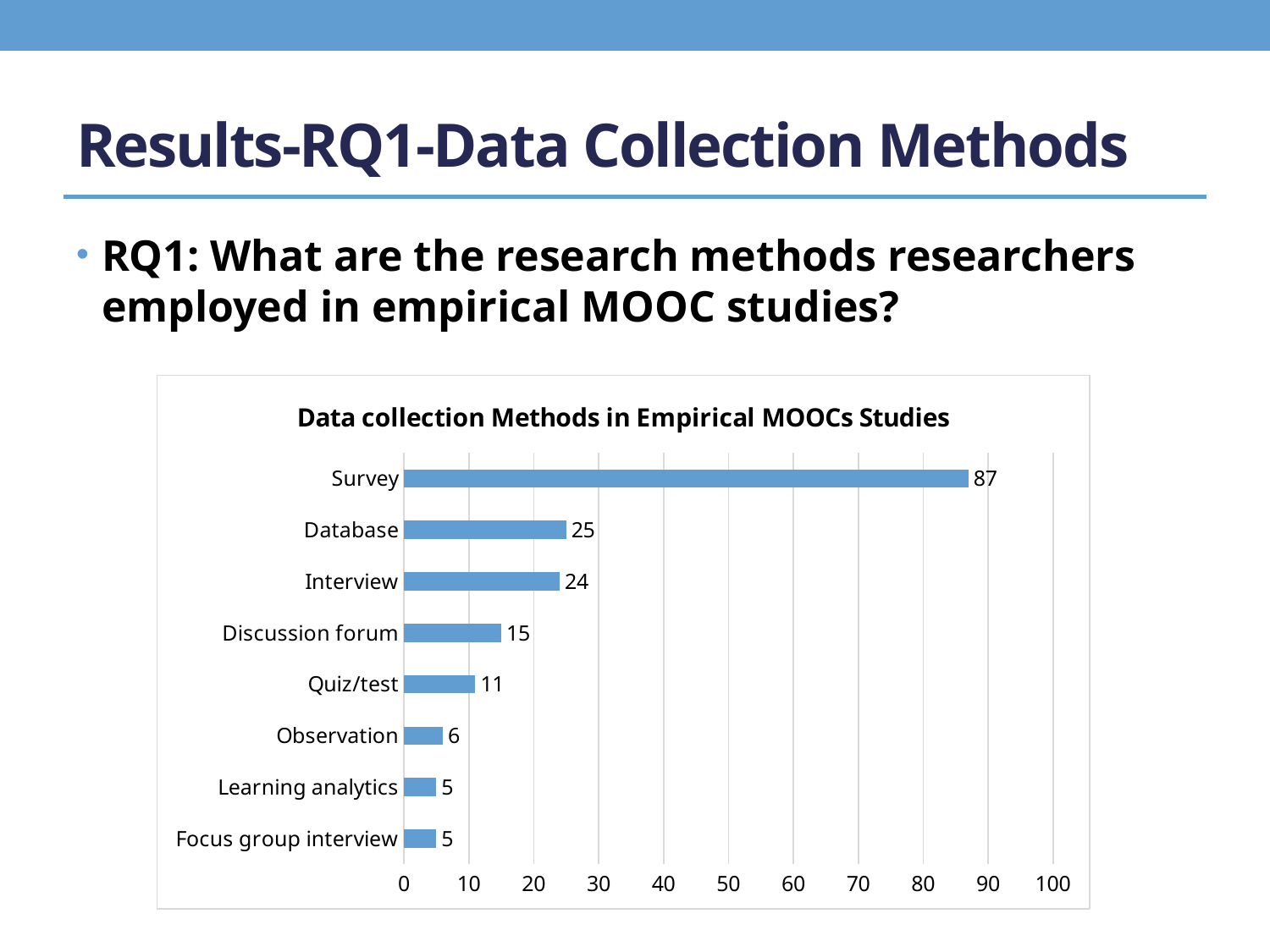
Which is larger, the value for Observation or the value for Discussion forum? Discussion forum Which is larger, the value for Database or the value for Quiz/test? Database How many data collection methods are shown in the chart? 8 What is the value for Discussion forum? 15 What is the value for Survey? 87 What is the title of the chart? Data collection Methods in Empirical MOOCs Studies What is the value for Quiz/test? 11 What kind of chart is shown on the slide? Bar chart Is the value for Survey greater or less than 80? greater What is the difference between the values for Interview and Discussion forum? 9 Which data collection method has the highest value? Survey What is the difference between the values for Survey and Database? 62